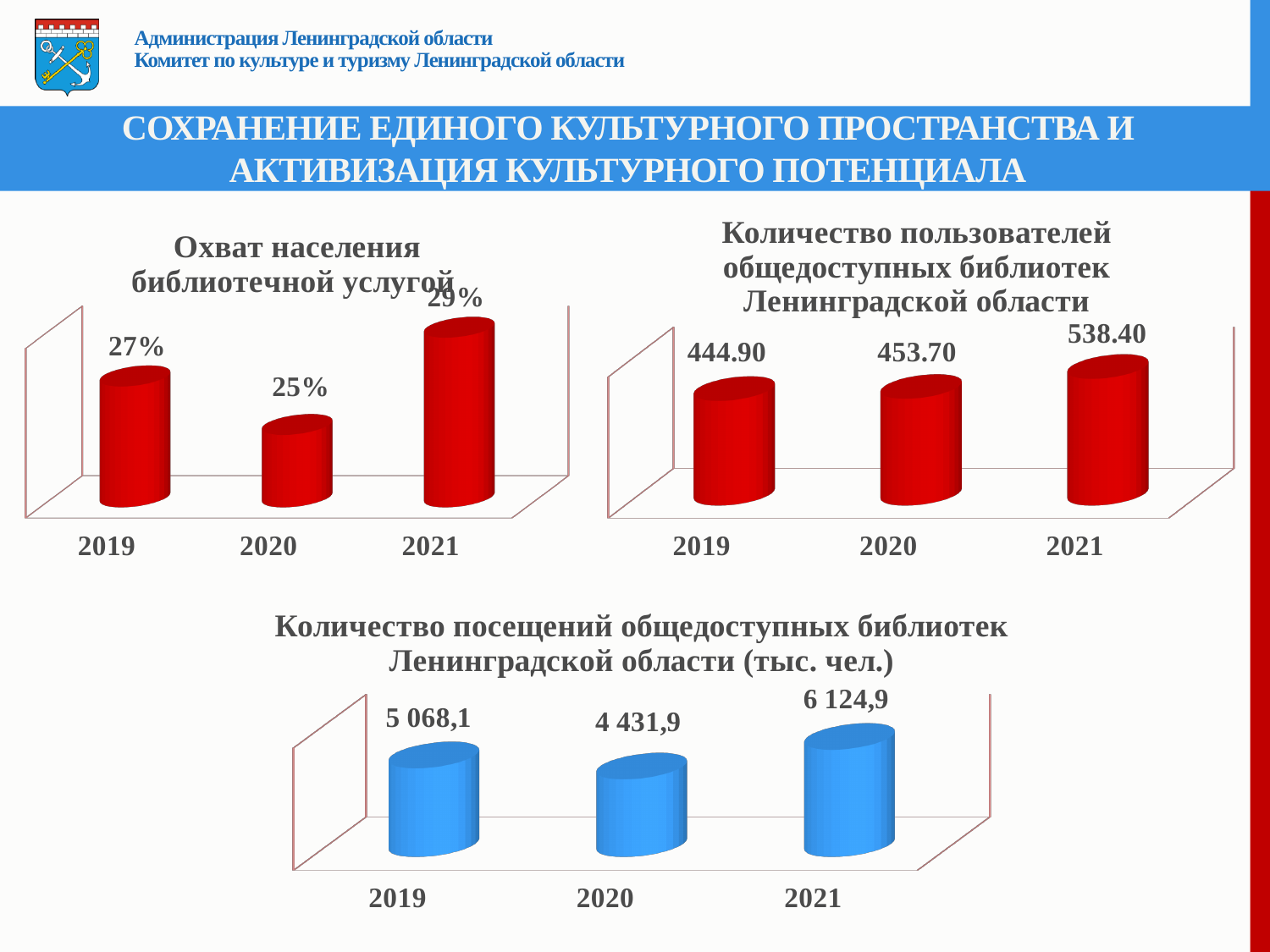
In the bottom chart 'Количество посещений общедоступных библиотек Ленинградской области (тыс. чел.)', which year has the lowest value? 2020 How many years are shown in the bottom chart 'Количество посещений общедоступных библиотек Ленинградской области (тыс. чел.)'? 3 In the top-right chart 'Количество пользователей общедоступных библиотек Ленинградской области', what is the value for 2019? 444.90 What type of chart is the bottom chart 'Количество посещений общедоступных библиотек Ленинградской области (тыс. чел.)'? bar chart In the top-left chart 'Охват населения библиотечной услугой', what is the difference between the 2021 and 2020 values? 4% In the top-right chart 'Количество пользователей общедоступных библиотек Ленинградской области', what is the difference between the 2021 and 2019 values? 93.50 In the top-left chart 'Охват населения библиотечной услугой', what is the value for 2020? 25% In the top-right chart 'Количество пользователей общедоступных библиотек Ленинградской области', which year has the lowest value? 2019 In the bottom chart 'Количество посещений общедоступных библиотек Ленинградской области (тыс. чел.)', what is the value for 2021? 6 124,9 In the top-left chart 'Охват населения библиотечной услугой', which year has the highest value? 2021 In the top-right chart 'Количество пользователей общедоступных библиотек Ленинградской области', do the values rise or fall from 2019 to 2021? rise In the bottom chart 'Количество посещений общедоступных библиотек Ленинградской области (тыс. чел.)', which is larger, the value for 2019 or 2020? 2019